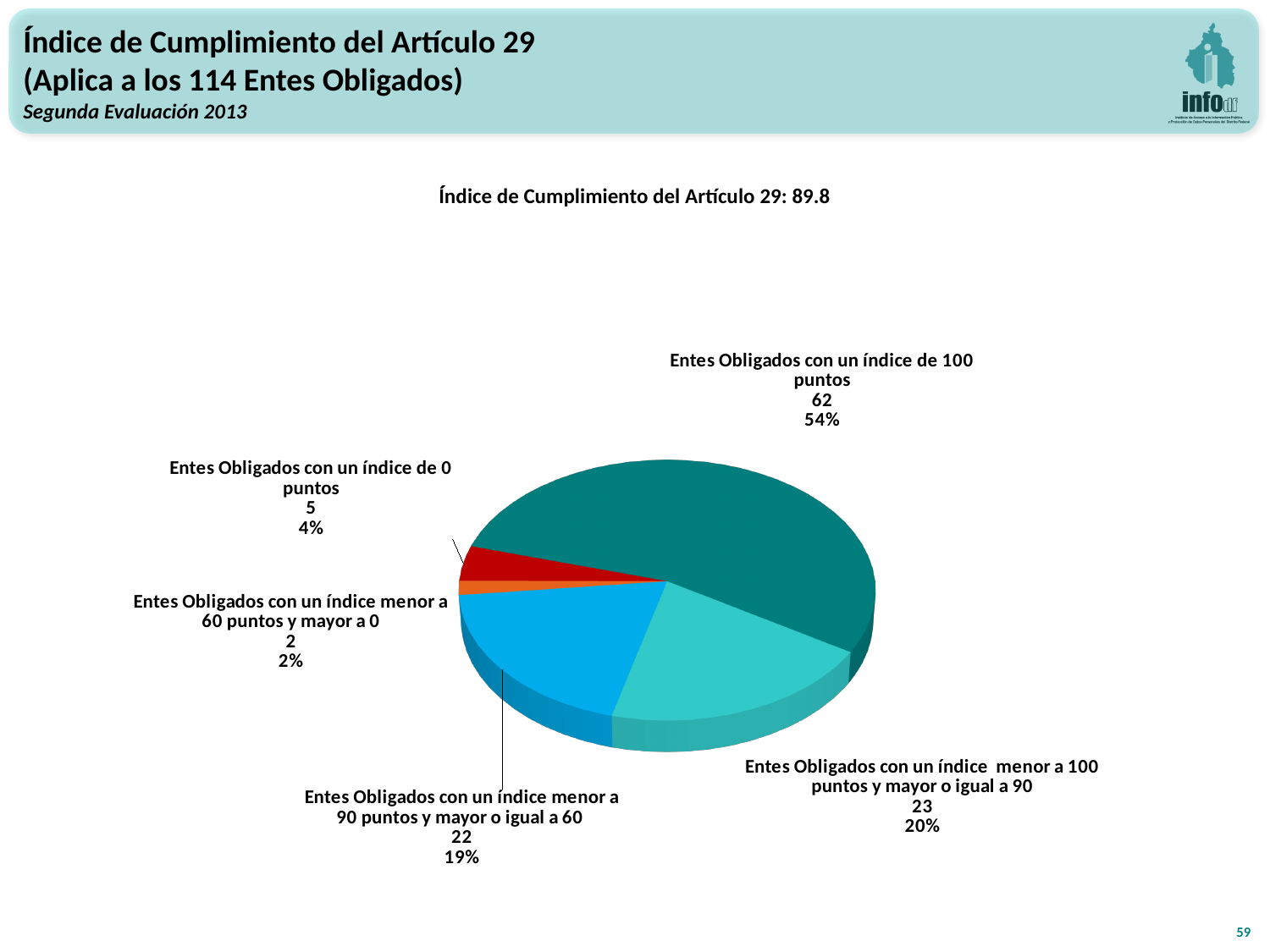
What share of the pie corresponds to Entes Obligados with an index of 100 points? 54% How many slices does the pie chart have? 5 What kind of chart is shown on the slide? Pie chart Which category has the largest slice of the pie? Entes Obligados con un índice de 100 puntos How many Entes Obligados have an index less than 100 points and greater than or equal to 90? 23 What is the Índice de Cumplimiento del Artículo 29 value stated above the chart? 89.8 How many Entes Obligados have an index of 100 points? 62 What is the difference between the number of Entes Obligados with an index of 100 points and those with an index less than 100 and greater than or equal to 90? 39 How many Entes Obligados have an index of 0 points? 5 What percentage is shown for Entes Obligados with an index less than 90 points and greater than or equal to 60? 19% Which is larger: the number of Entes Obligados with an index of 0 points or those with an index less than 60 points and greater than 0? Entes Obligados con un índice de 0 puntos Which category has the smallest slice of the pie? Entes Obligados con un índice menor a 60 puntos y mayor a 0